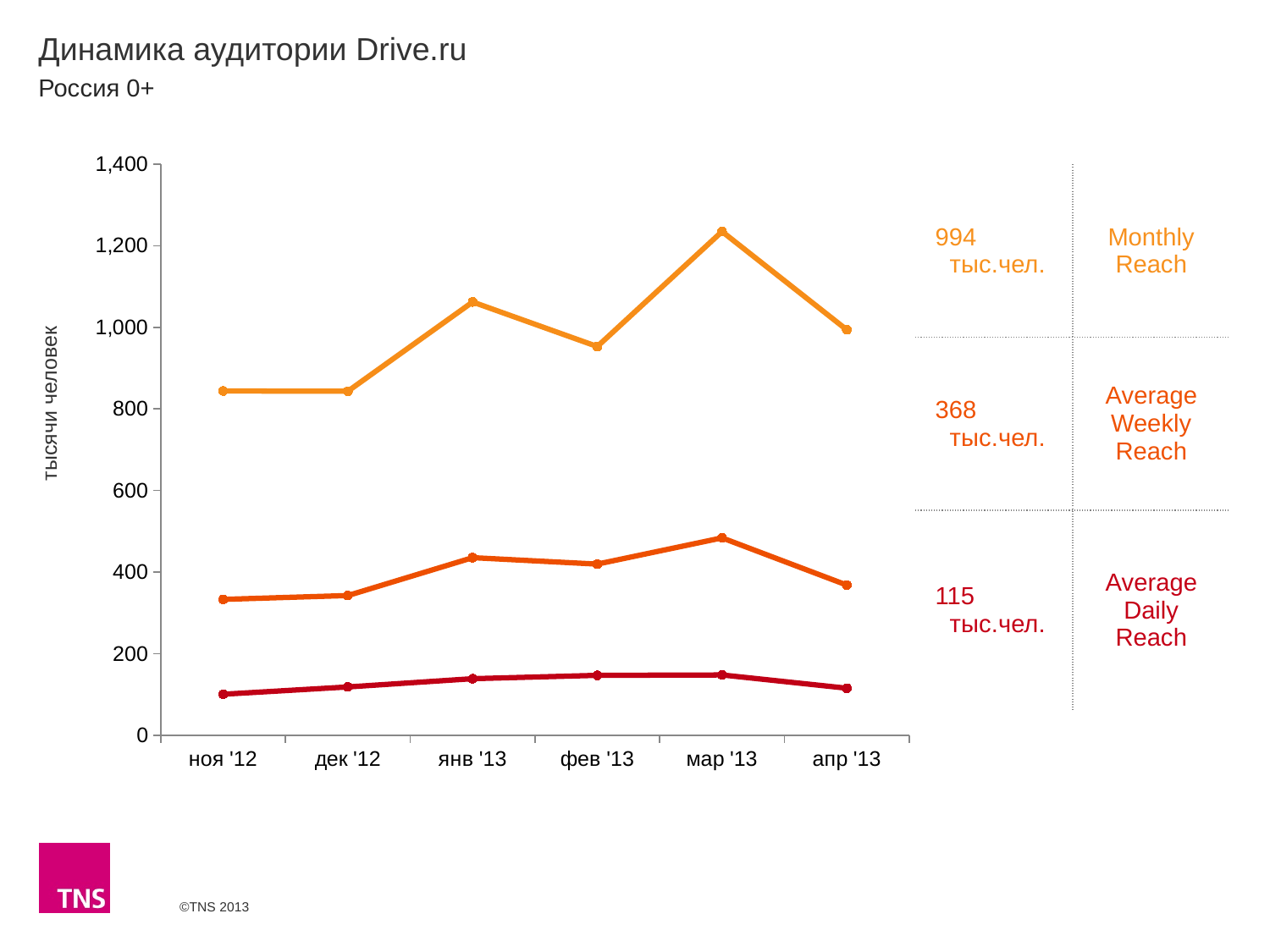
How many series are shown in the chart? 3 In which month does Average Weekly Reach reach its highest value? мар '13 Is the Monthly Reach value for мар '13 greater or less than 1,200? greater Is the Average Daily Reach value for фев '13 greater or less than 200? less What Monthly Reach figure is printed on the right side of the slide? 994 тыс.чел. Does Monthly Reach rise or fall from мар '13 to апр '13? fall In which month does Monthly Reach reach its highest value? мар '13 How many months are plotted along the x axis? 6 Is the Average Weekly Reach value for янв '13 greater or less than 400? greater What kind of chart is shown on the slide? line chart Which is larger in фев '13: Monthly Reach or Average Weekly Reach? Monthly Reach